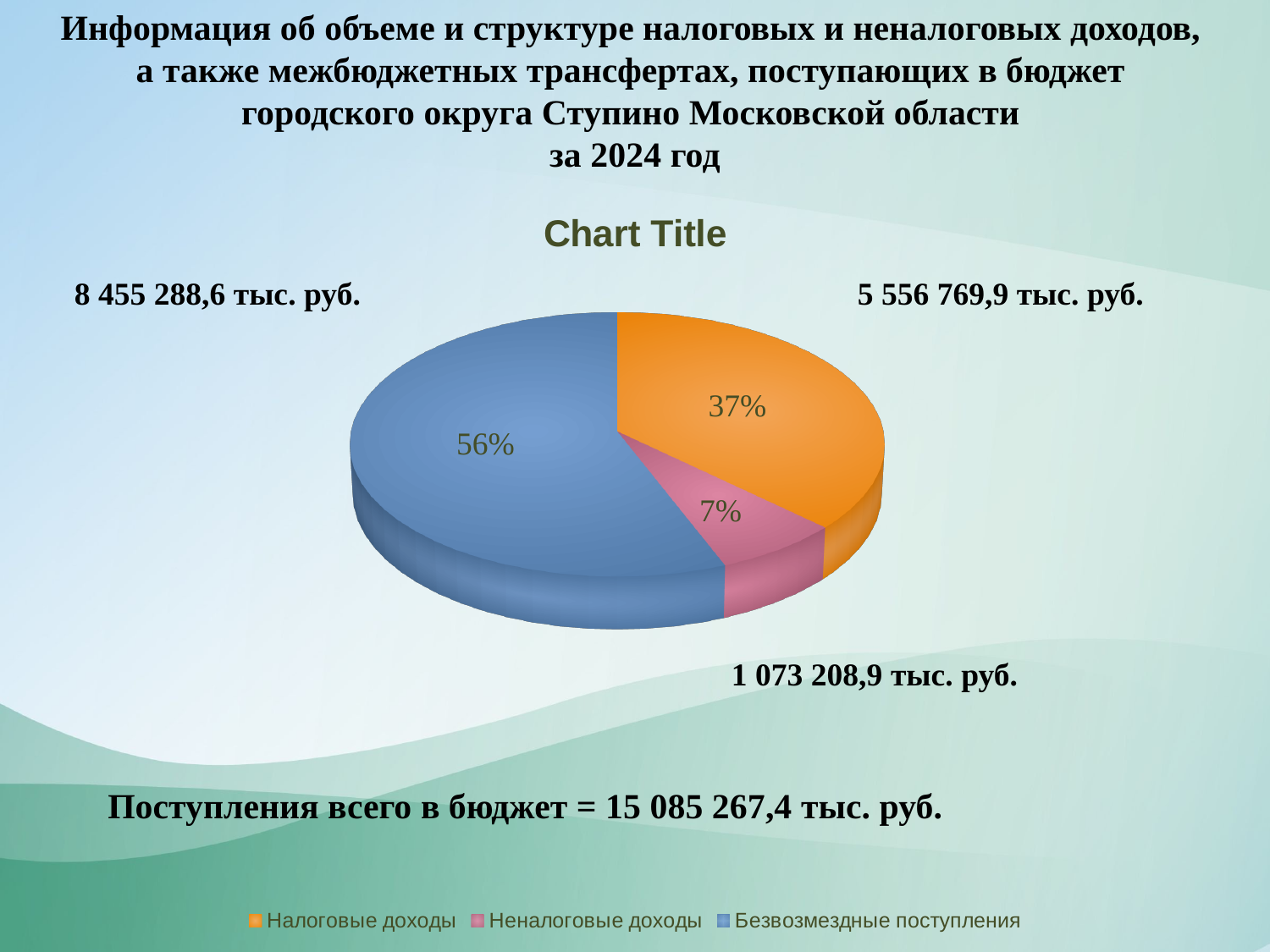
How many entries does the legend list? 3 Which category has the largest slice of the pie? Безвозмездные поступления What share of the pie does Безвозмездные поступления represent? 56% How many slices does the pie chart have? 3 Which category has the smallest slice of the pie? Неналоговые доходы What is the title shown above the chart? Chart Title What share of the pie does Неналоговые доходы represent? 7% Which colour represents Неналоговые доходы in the chart? Pink Which is larger, the share for Налоговые доходы or the share for Неналоговые доходы? Налоговые доходы What share of the pie does Налоговые доходы represent? 37% By how many percentage points does the share of Безвозмездные поступления exceed the share of Налоговые доходы? 19 percentage points What kind of chart is shown on the slide? Pie chart